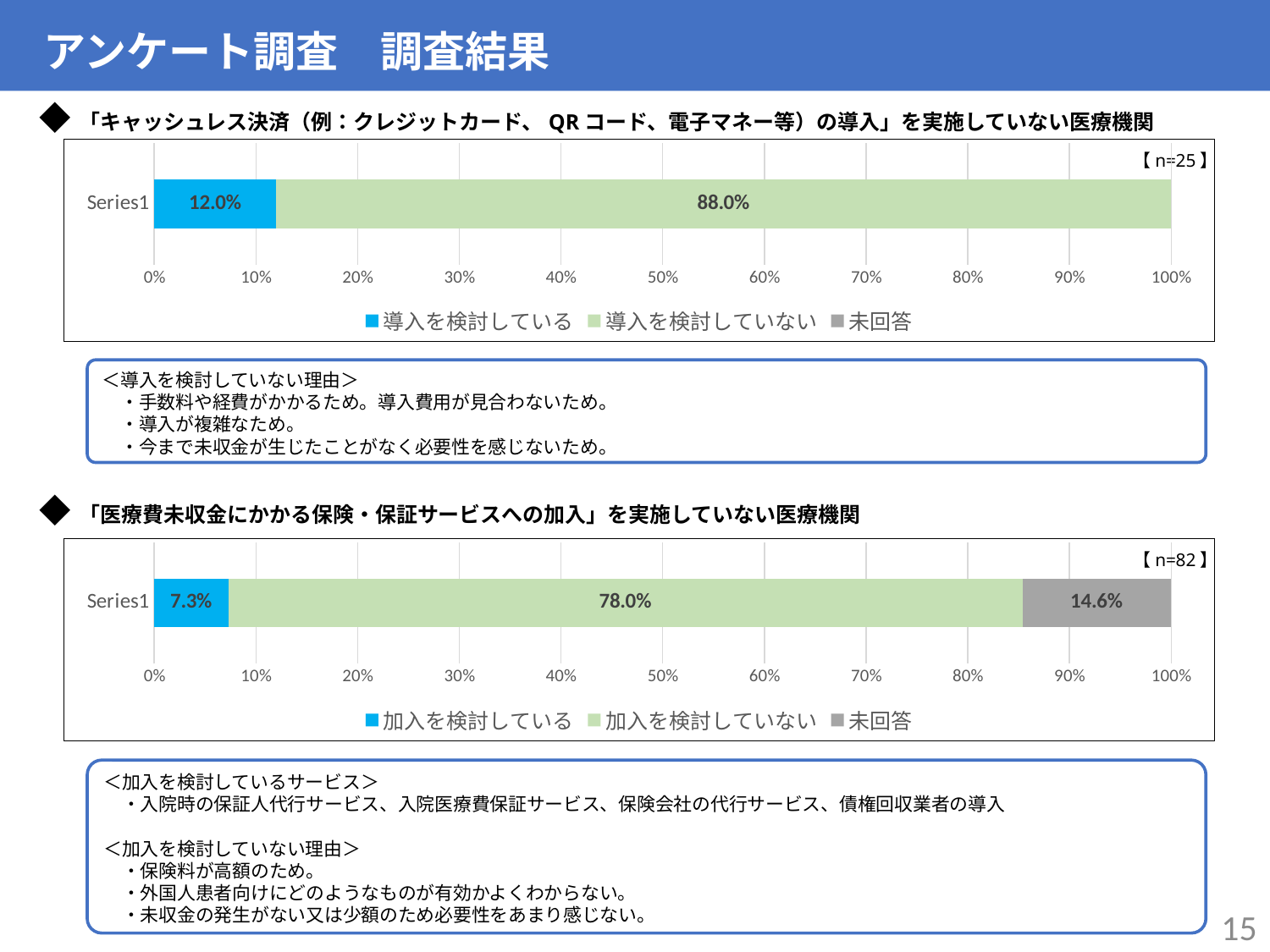
In the bottom chart (insurance/guarantee services), what percentage are 未回答? 14.6% What type of chart is used on this slide? Stacked bar chart In the top chart (cashless payment), what percentage of medical institutions are 導入を検討している? 12.0% What is the sample size (n) shown for the top chart? 25 In the bottom chart, which segment is the smallest? 加入を検討している How many series does the legend of the bottom chart list? 3 In the bottom chart, which segment is the largest? 加入を検討していない In the top chart, what is the difference between 導入を検討していない and 導入を検討している? 76.0% In the bottom chart (insurance/guarantee services), what percentage are 加入を検討している? 7.3% What is the sample size (n) shown for the bottom chart? 82 In the bottom chart, which is larger: 未回答 or 加入を検討している? 未回答 In the top chart (cashless payment), what percentage of medical institutions are 導入を検討していない? 88.0%